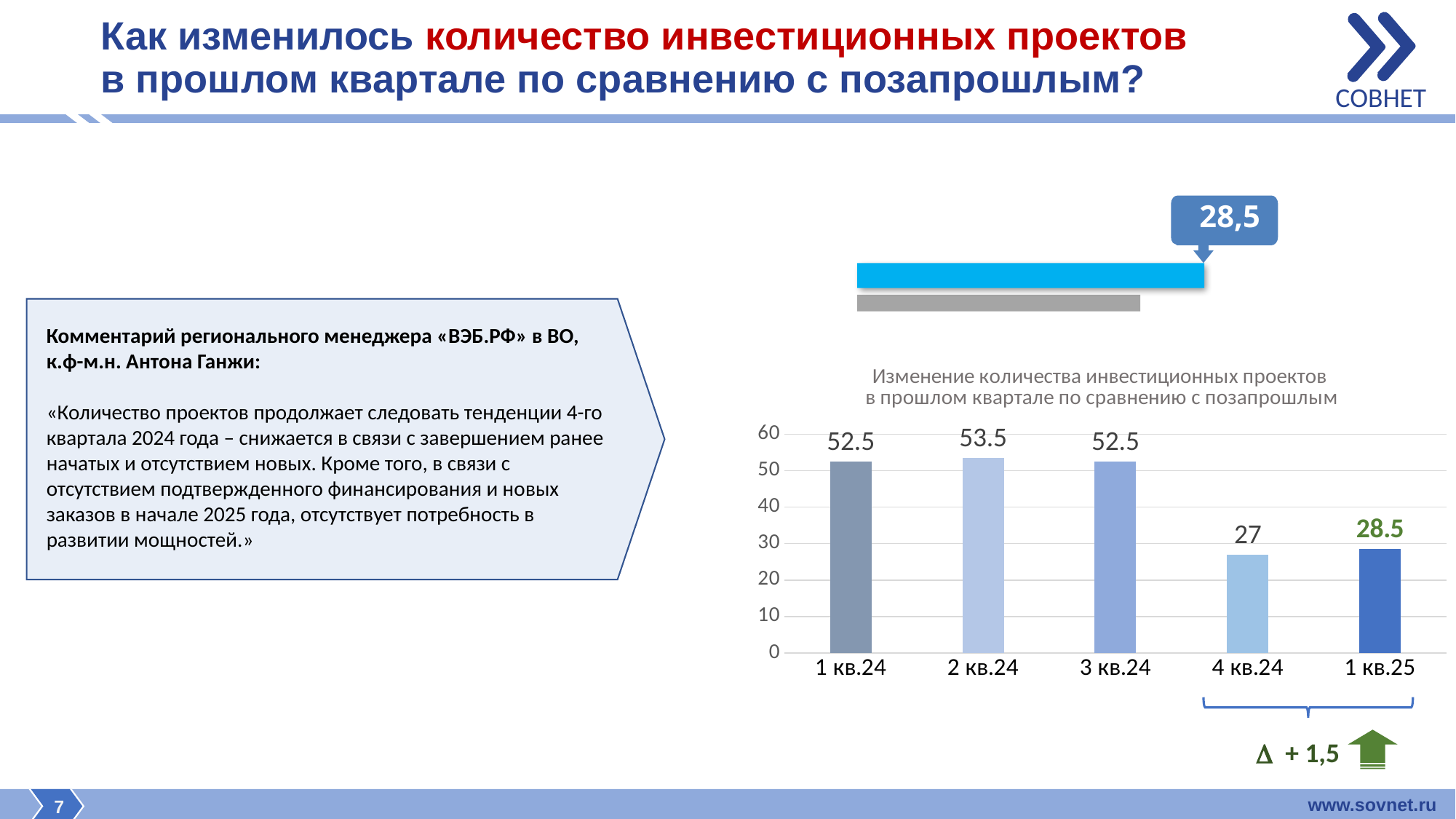
What is the value for 2 кв.24? 53.5 What is the title of the chart? Изменение количества инвестиционных проектов в прошлом квартале по сравнению с позапрошлым What is the value for 1 кв.24? 52.5 Which is larger, the value for 3 кв.24 or the value for 4 кв.24? 3 кв.24 Which quarter has the lowest value? 4 кв.24 What is the difference between the values for 1 кв.25 and 4 кв.24? 1.5 What is the value for 1 кв.25? 28.5 What kind of chart is shown? bar chart How many quarters are shown on the x axis? 5 What is the value for 4 кв.24? 27 What is the difference between the values for 3 кв.24 and 4 кв.24? 25.5 Which quarter has the highest value? 2 кв.24